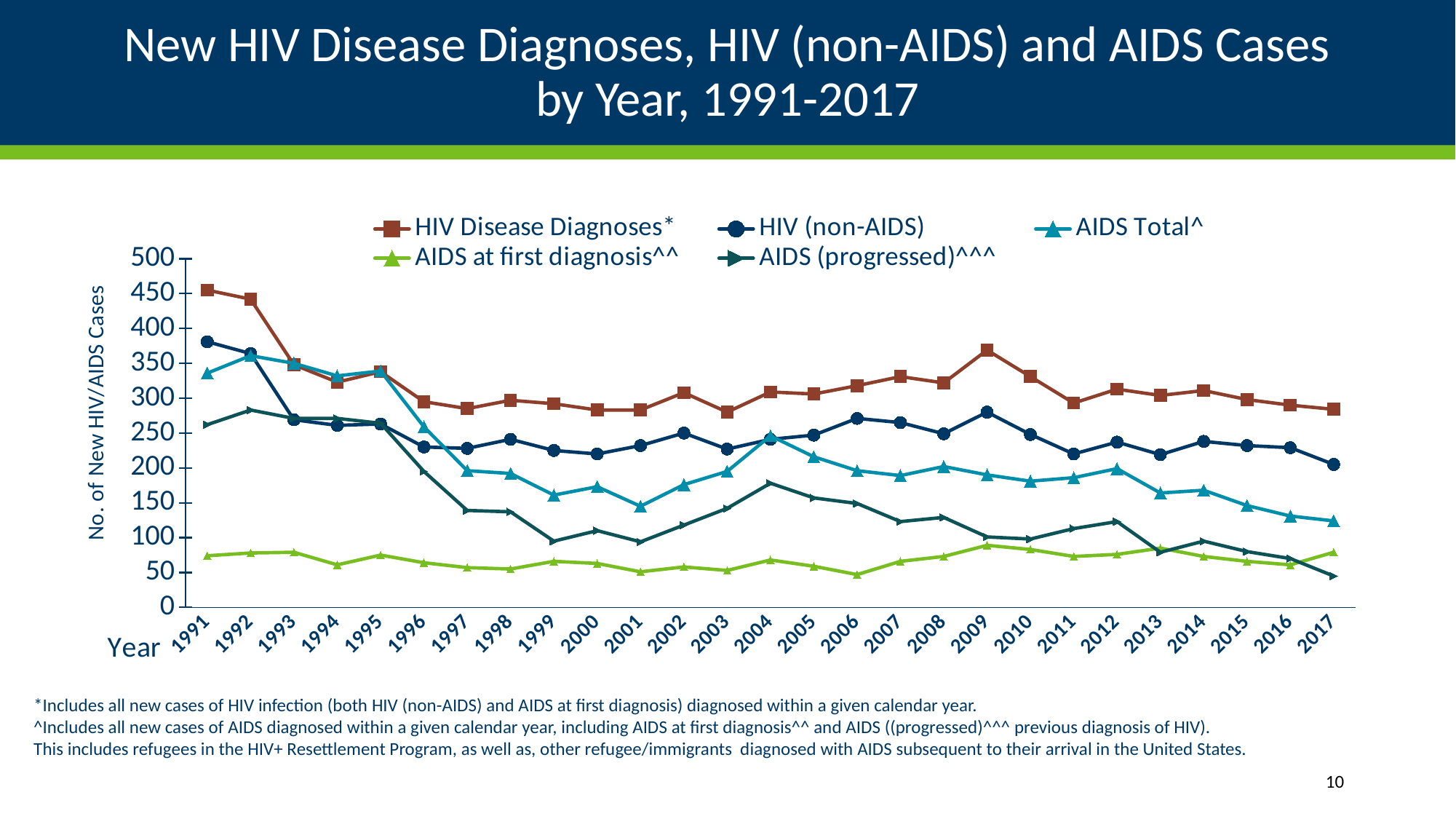
Overall, does the HIV Disease Diagnoses* series rise or fall from 1991 to 2017? fall Is the value for HIV Disease Diagnoses* in 1991 greater or less than 400? greater In which year is the AIDS (progressed)^^^ series at its highest? 1992 What kind of chart is shown on the slide? line chart How many years are plotted along the x axis? 27 In which year is the HIV (non-AIDS) series at its highest? 1991 Is the value for AIDS at first diagnosis^^ in 2001 greater or less than 100? less How many series does the legend list? 5 Is the value for AIDS Total^ in 1992 greater or less than 300? greater In which year is the HIV Disease Diagnoses* series at its highest? 1991 In 2017, which is larger: HIV (non-AIDS) or AIDS Total^? HIV (non-AIDS)